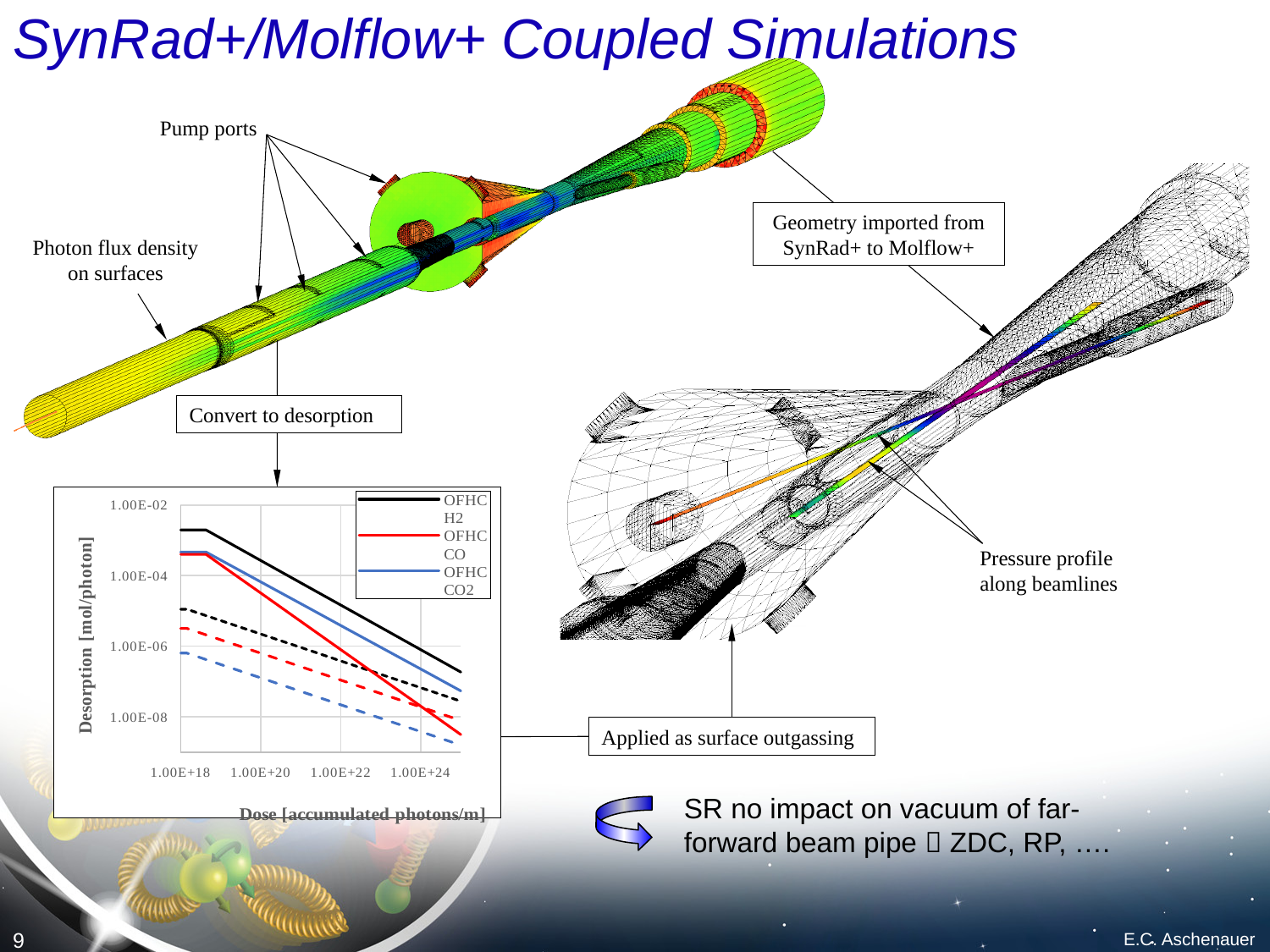
In the desorption chart, which legend series' colour corresponds to the lowest curve on the chart? OFHC CO2 How many tick labels are shown on the x axis of the desorption chart? 4 What is the label of the x axis of the desorption chart? Dose [accumulated photons/m] What kind of chart is shown at the bottom left of the slide? line chart How many series does the legend of the desorption chart list? 3 What is the lowest tick value shown on the y axis of the desorption chart? 1.00E-08 In the desorption chart, is the solid OFHC H2 line at a dose of 1.00E+18 greater or less than 1.00E-04? greater In the desorption chart, do the desorption values rise or fall as the dose increases? fall In the desorption chart, at a dose of 1.00E+18, which solid line is higher: OFHC H2 or OFHC CO? OFHC H2 In the desorption chart, which legend series has the highest desorption at a dose of 1.00E+18? OFHC H2 What is the label of the y axis of the desorption chart? Desorption [mol/photon] In the desorption chart, is the dashed black line at a dose of 1.00E+18 greater or less than 1.00E-06? greater